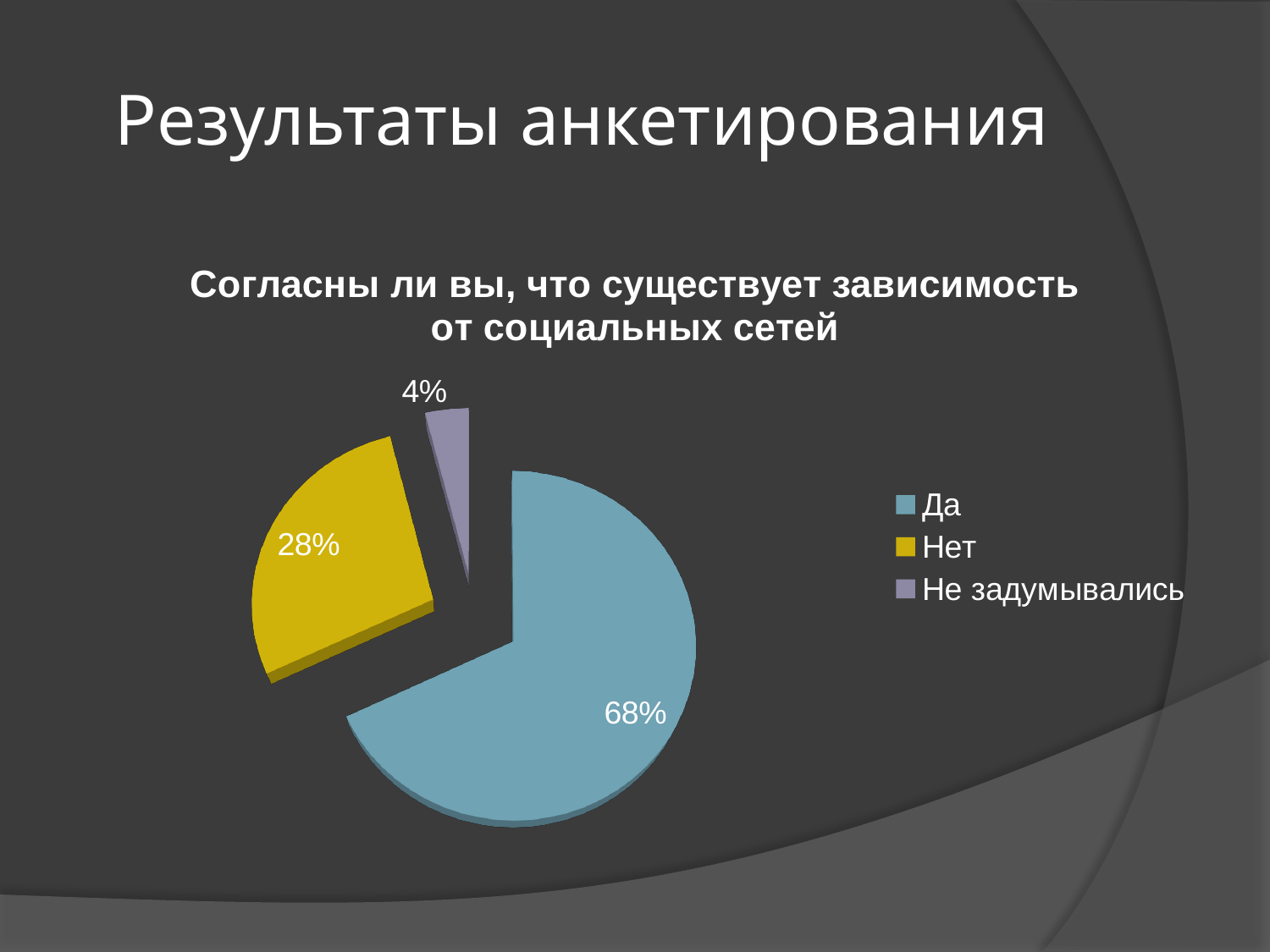
Which is larger, the share for "Нет" or the share for "Не задумывались"? Нет Which category has the largest slice of the pie? Да Which category has the smallest slice of the pie? Не задумывались What is the title of the chart? Согласны ли вы, что существует зависимость от социальных сетей How many entries does the legend list? 3 What share of the pie does "Нет" represent? 28% How many slices does the pie chart have? 3 What is the difference in percentage points between "Нет" and "Не задумывались"? 24 What share of the pie does "Не задумывались" represent? 4% What kind of chart is shown on the slide? Pie chart What is the difference in percentage points between "Да" and "Нет"? 40 What share of the pie does "Да" represent? 68%